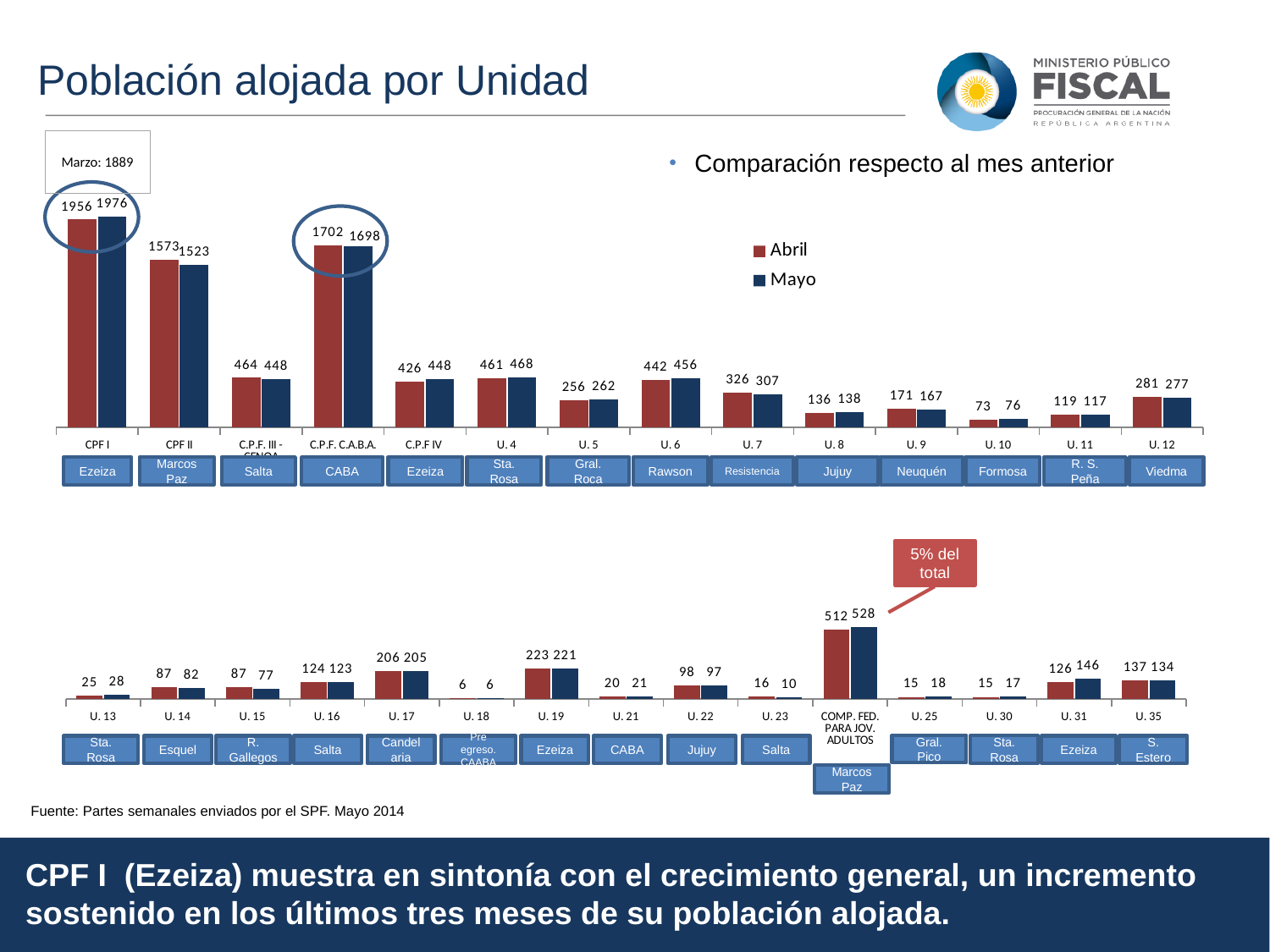
How many categories are shown on the x axis of the bottom chart? 15 In the top chart, what is the Mayo value for CPF I? 1976 In the bottom chart, what is the difference between the Mayo and Abril values for U. 31? 20 In the top chart, which category has the lowest Abril value? U. 10 What kind of chart is the bottom chart? Bar chart In the bottom chart, which category has the lowest Mayo value? U. 18 In the top chart, what is the Abril value for C.P.F. C.A.B.A.? 1702 In the top chart, which category has the highest Mayo value? CPF I In the bottom chart, what is the Mayo value for COMP. FED. PARA JOV. ADULTOS? 528 In the top chart, which is larger for U. 7: the Abril value or the Mayo value? Abril How many series does the legend of the top chart list? 2 In the top chart, what is the difference between the Abril and Mayo values for CPF II? 50